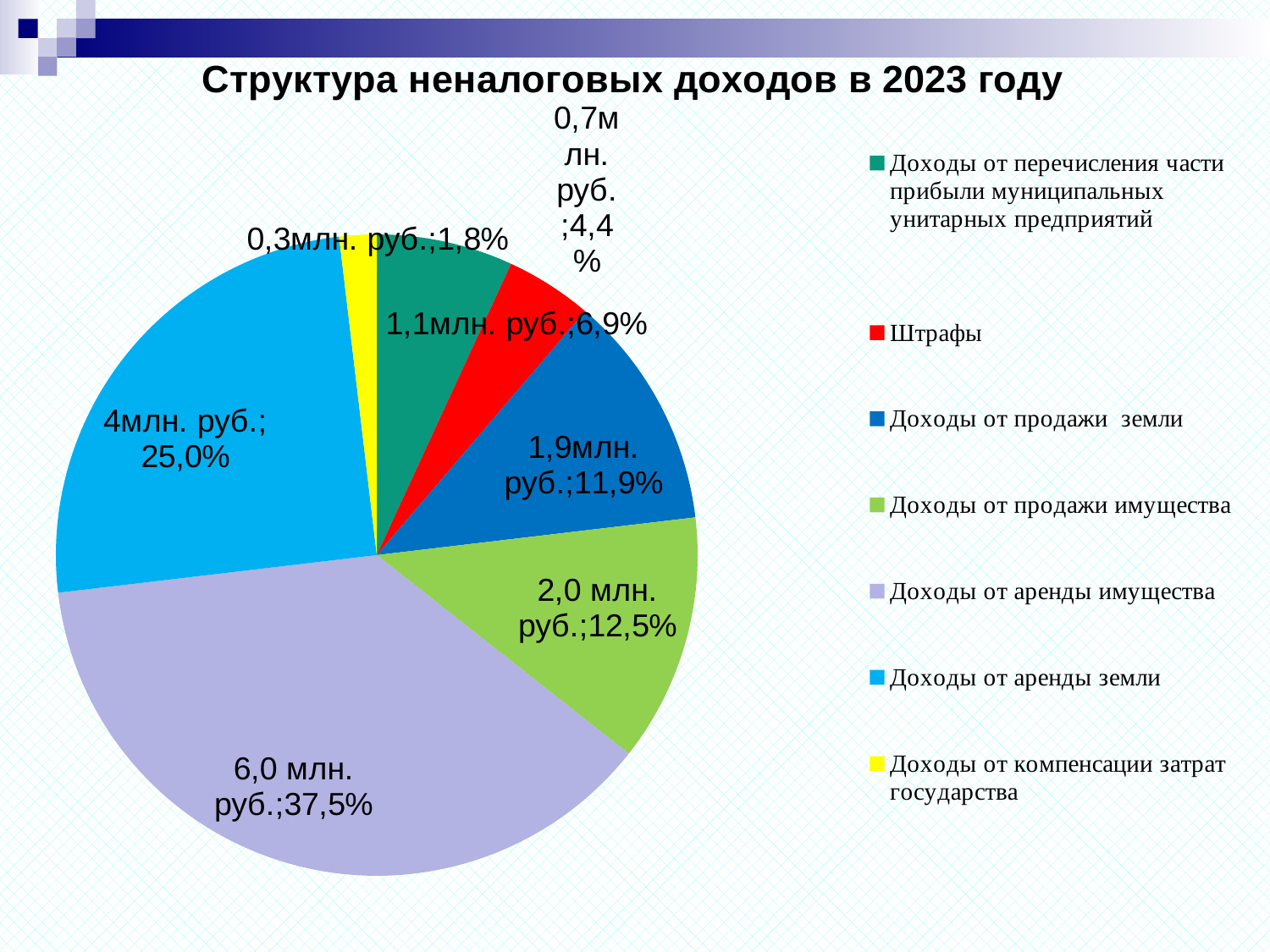
What share of the pie does "Доходы от продажи земли" have? 11,9% Which category has the largest share of the pie? Доходы от аренды имущества What is the value shown for "Доходы от аренды земли"? 4млн. руб. How many slices does the pie chart have? 7 What is the difference in value between "Доходы от аренды имущества" and "Доходы от аренды земли"? 2,0 млн. руб. What is the value shown for "Доходы от продажи имущества"? 2,0 млн. руб. Which is larger: "Доходы от аренды земли" or "Доходы от продажи имущества"? Доходы от аренды земли Which category has the smallest share of the pie? Доходы от компенсации затрат государства What share of the pie does "Доходы от аренды имущества" have? 37,5% What share of the pie does "Доходы от компенсации затрат государства" have? 1,8% What is the title of the chart? Структура неналоговых доходов в 2023 году What kind of chart is shown on the slide? pie chart